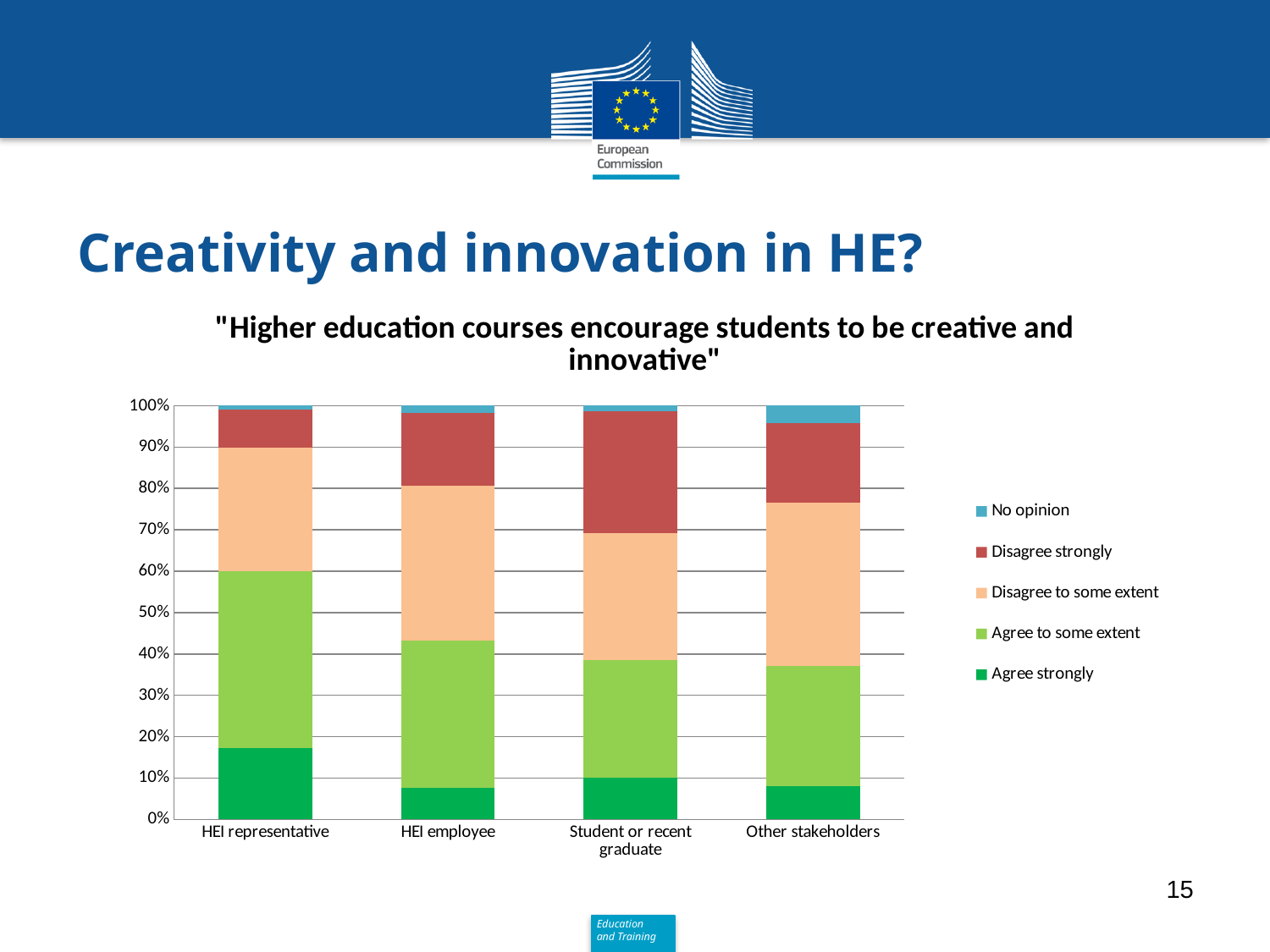
How many respondent categories are shown on the x axis of the chart? 4 Which respondent category has the largest 'Disagree strongly' segment? Student or recent graduate How many series does the chart legend list? 5 What is the title of the chart? "Higher education courses encourage students to be creative and innovative" Which respondent category has the largest 'No opinion' segment? Other stakeholders Is the 'Agree strongly' share for HEI representative greater or less than 10%? greater Which has the larger 'Disagree to some extent' segment, Other stakeholders or HEI representative? Other stakeholders Is the 'Agree strongly' share for HEI employee greater or less than 10%? less Which respondent category has the largest 'Agree strongly' segment? HEI representative What kind of chart is shown on the slide? Stacked bar chart Which has the larger 'Agree to some extent' segment, HEI representative or HEI employee? HEI representative Is the 'Disagree strongly' share for Student or recent graduate greater or less than 20%? greater